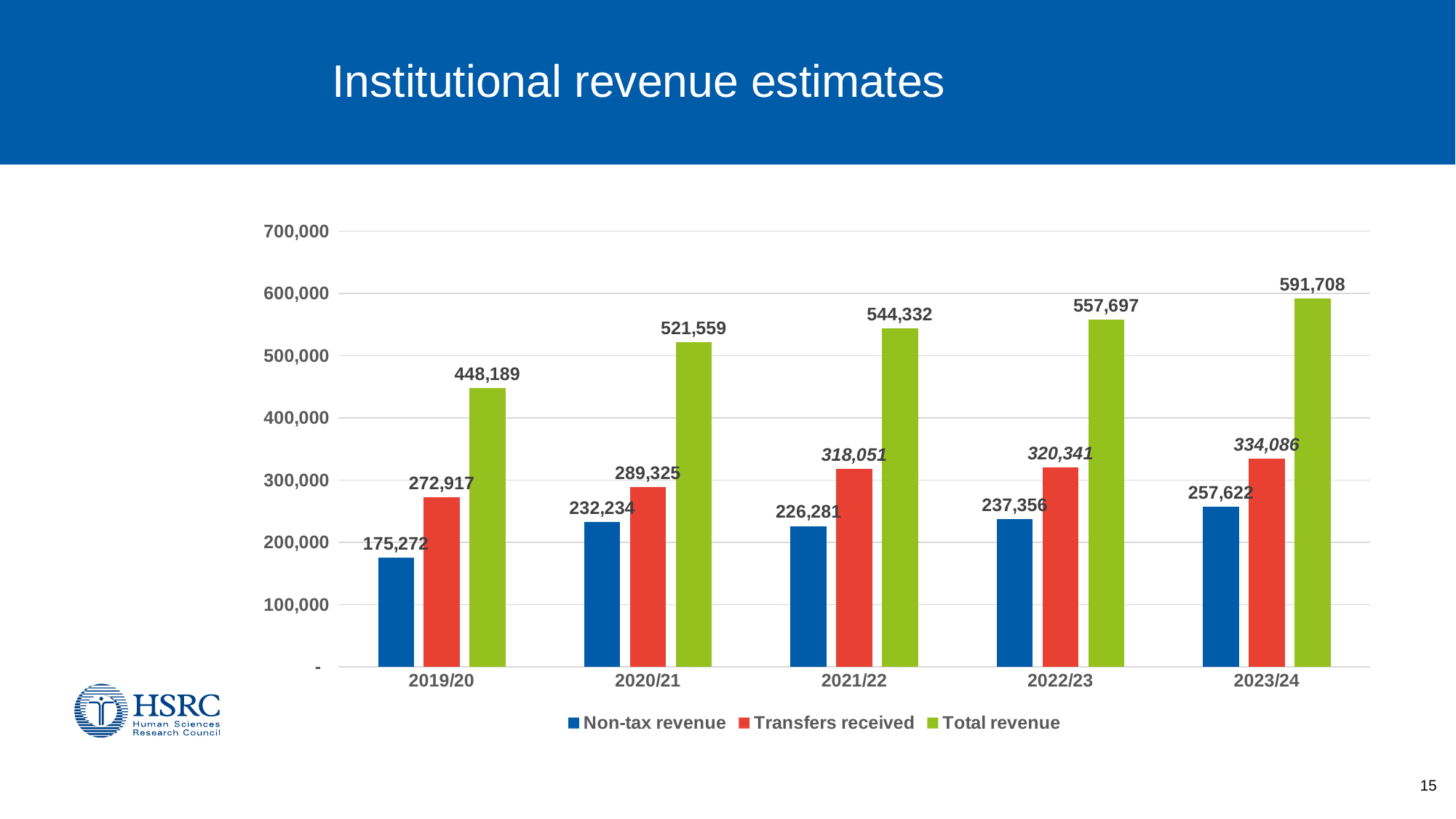
What is the Non-tax revenue for 2019/20? 175,272 In 2023/24, which is larger: Transfers received or Non-tax revenue? Transfers received What is the Total revenue for 2023/24? 591,708 What is the difference between Total revenue in 2023/24 and Total revenue in 2019/20? 143,519 Which year has the highest Total revenue? 2023/24 What kind of chart is shown on the slide? Bar chart Is the Total revenue for 2020/21 greater or less than 500,000? greater How many series does the legend list? 3 How many years are shown on the x axis? 5 Does Total revenue rise or fall from 2019/20 to 2023/24? Rise What is the value of Transfers received in 2021/22? 318,051 Which year has the lowest Non-tax revenue? 2019/20